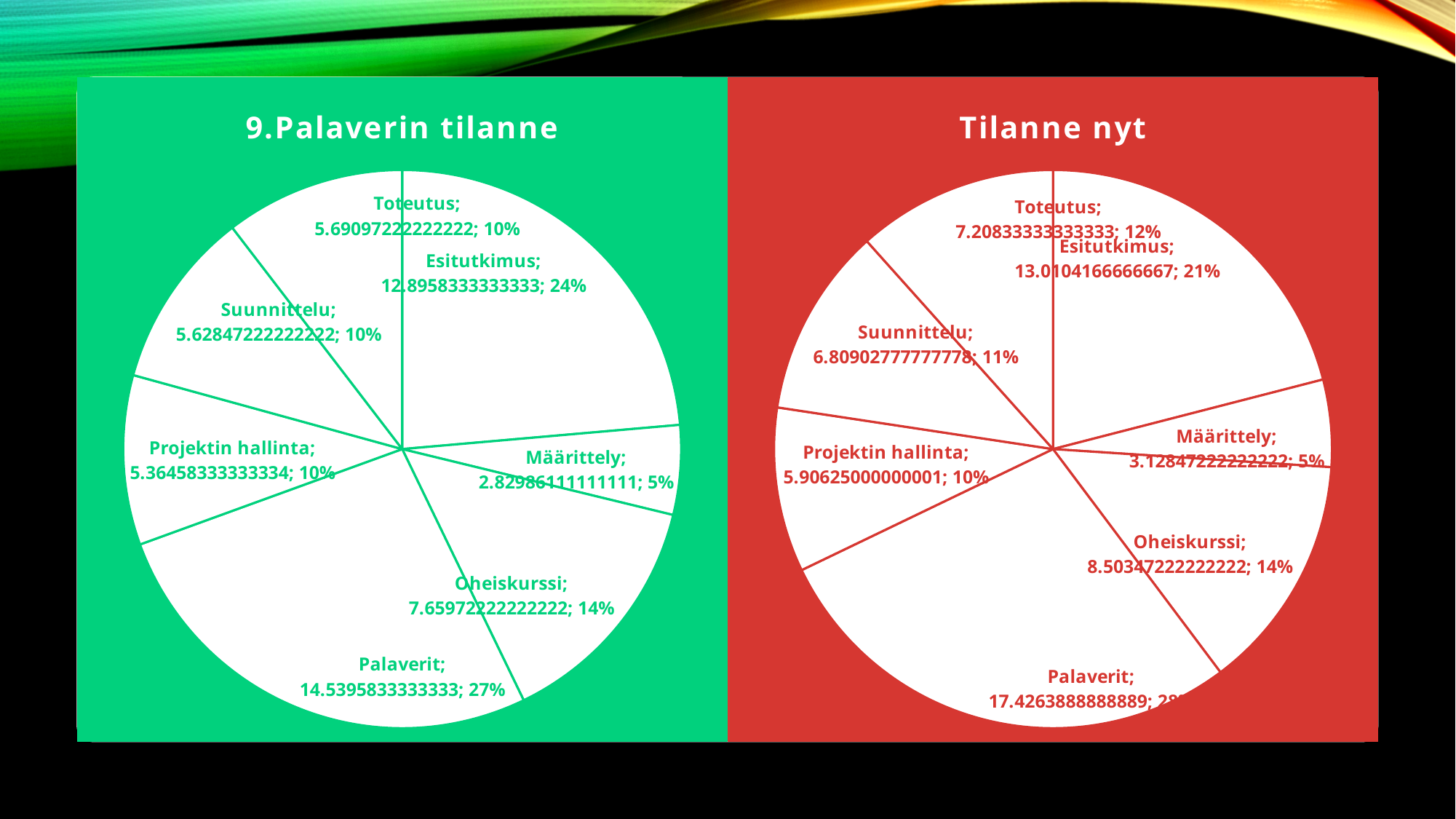
In the "9.Palaverin tilanne" chart, what percentage share does Palaverit have? 27% In the "9.Palaverin tilanne" chart, what is the value shown for Esitutkimus? 12.8958333333333 What kind of chart is used on the right side of the slide, titled "Tilanne nyt"? Pie chart In the "9.Palaverin tilanne" chart, what percentage share does Oheiskurssi have? 14% In the "Tilanne nyt" chart, which is larger, Suunnittelu or Projektin hallinta? Suunnittelu In the "Tilanne nyt" chart, which category has the smallest slice? Määrittely In the "9.Palaverin tilanne" chart, which category has the smallest slice? Määrittely How many slices does the "9.Palaverin tilanne" pie chart have? 7 What is the title of the chart on the left side of the slide? 9.Palaverin tilanne In the "Tilanne nyt" chart, what is the value shown for Toteutus? 7.20833333333333 In the "Tilanne nyt" chart, what percentage share does Esitutkimus have? 21% In the "9.Palaverin tilanne" chart, which category has the largest slice? Palaverit